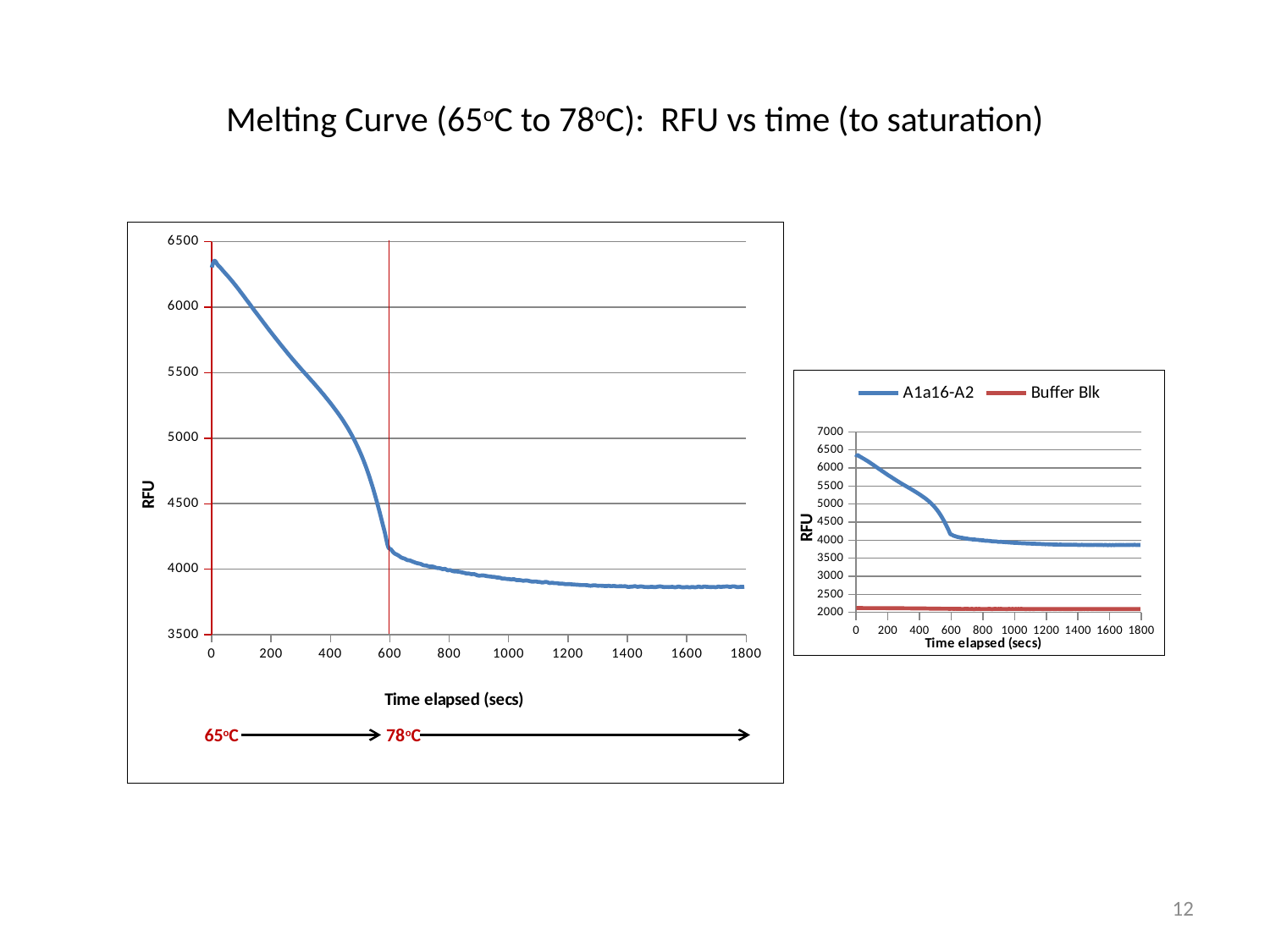
How many series does the legend of the small chart on the right list? 2 In the large chart on the left, is the RFU value at 600 secs greater or less than 4500? less In the small chart on the right, does the A1a16-A2 series rise or fall over time? fall In the small chart on the right, is the Buffer Blk value at 1000 secs greater or less than 2500? less In the large chart on the left, is the RFU value at 1800 secs greater or less than 4000? less What kind of chart is the large chart on the left of the slide? line chart In the large chart on the left, do the RFU values rise or fall as time elapsed increases? fall What are the legend entries of the small chart on the right? A1a16-A2 and Buffer Blk In the small chart on the right, which series has the higher RFU value at 1800 secs, A1a16-A2 or Buffer Blk? A1a16-A2 What is the x-axis title of the large chart on the left? Time elapsed (secs)